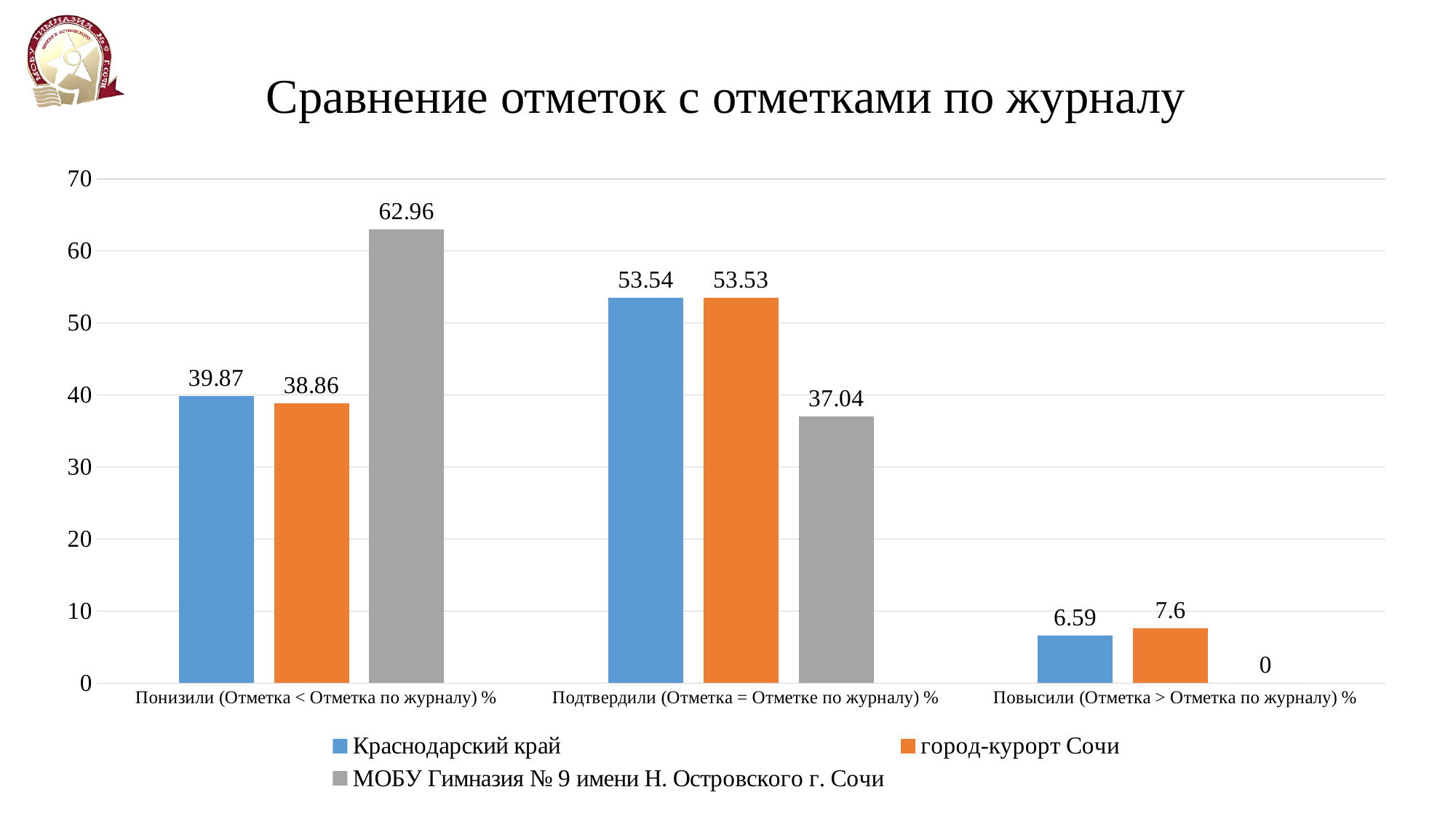
What is the difference between the values for МОБУ Гимназия № 9 имени Н. Островского г. Сочи and Краснодарский край in the category Понизили (Отметка < Отметка по журналу) %? 23.09 What is the value for МОБУ Гимназия № 9 имени Н. Островского г. Сочи in the category Повысили (Отметка > Отметка по журналу) %? 0 What is the value for город-курорт Сочи in the category Повысили (Отметка > Отметка по журналу) %? 7.6 How many series does the legend list? 3 Is the value for МОБУ Гимназия № 9 имени Н. Островского г. Сочи in the category Подтвердили (Отметка = Отметке по журналу) % greater or less than 40? less How many categories are shown on the x axis? 3 What is the value for Краснодарский край in the category Подтвердили (Отметка = Отметке по журналу) %? 53.54 Which is larger in the category Повысили (Отметка > Отметка по журналу) %: Краснодарский край or город-курорт Сочи? город-курорт Сочи Which series has the highest value in the category Понизили (Отметка < Отметка по журналу) %? МОБУ Гимназия № 9 имени Н. Островского г. Сочи What is the value for МОБУ Гимназия № 9 имени Н. Островского г. Сочи in the category Понизили (Отметка < Отметка по журналу) %? 62.96 What type of chart is shown on the slide? bar chart Which series has the lowest value in the category Подтвердили (Отметка = Отметке по журналу) %? МОБУ Гимназия № 9 имени Н. Островского г. Сочи